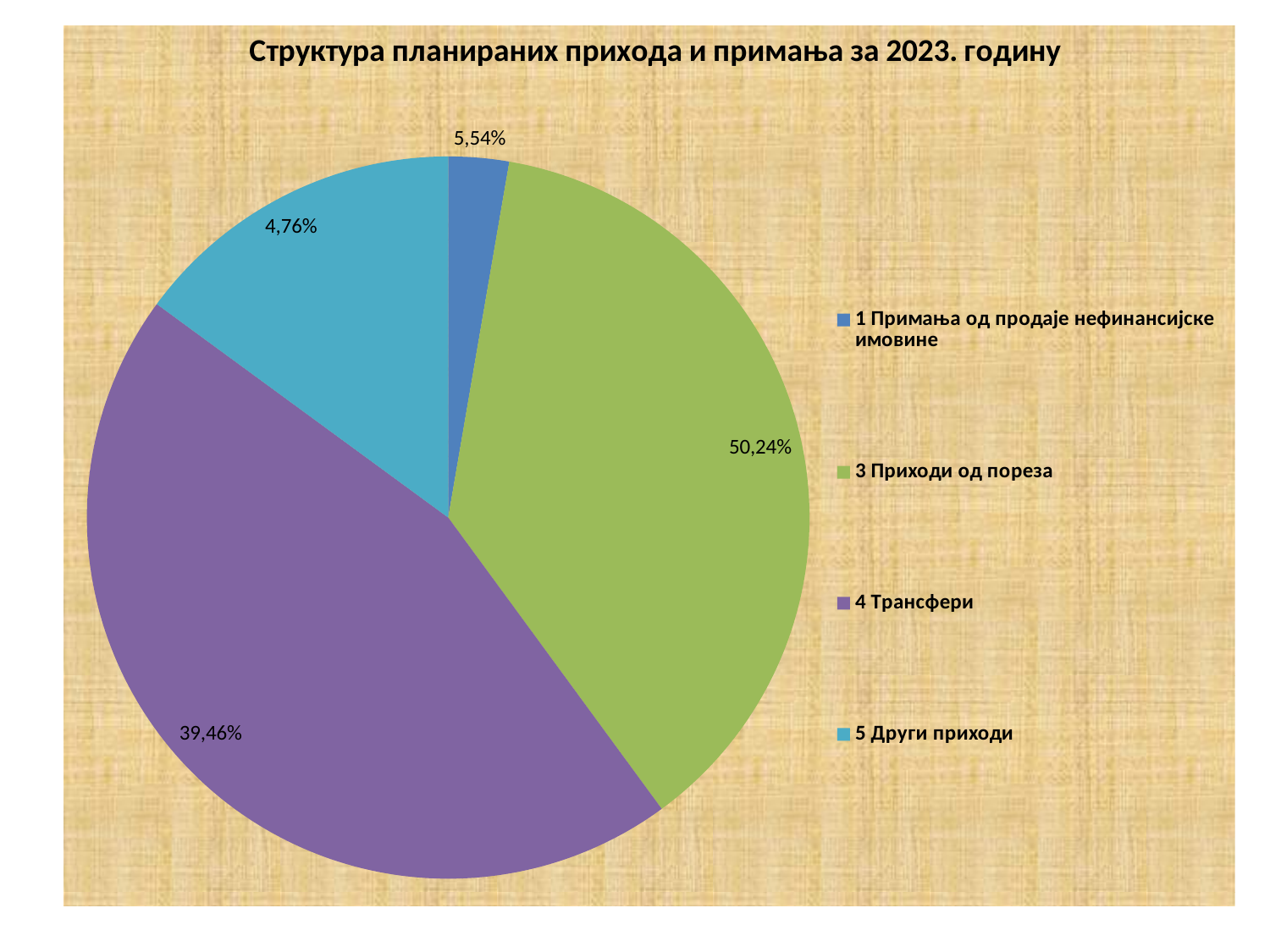
What is the title of the chart? Структура планираних прихода и примања за 2023. годину What type of chart is shown on the slide? pie chart What is the combined share of 3 Приходи од пореза and 4 Трансфери? 89,70% What is the difference between the shares of 3 Приходи од пореза and 4 Трансфери? 10,78% What share of the pie does 4 Трансфери have? 39,46% What colour is the slice for 4 Трансфери? purple What share of the pie does 3 Приходи од пореза have? 50,24% What value is shown for 5 Други приходи? 4,76% What value is shown for 1 Примања од продаје нефинансијске имовине? 5,54% How many categories does the legend list? 4